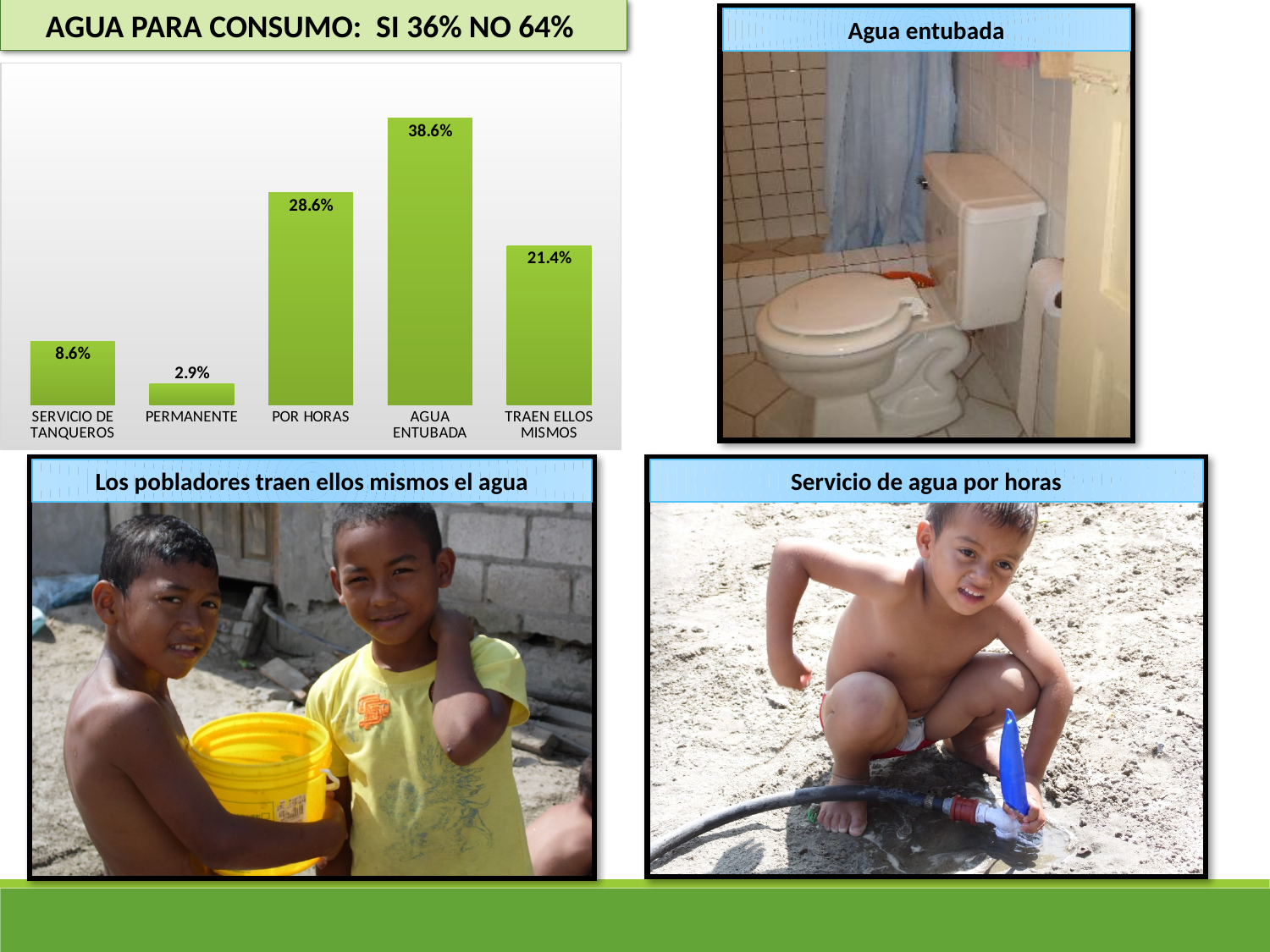
What is the title of the chart? AGUA PARA CONSUMO: SI 36% NO 64% What is the value for PERMANENTE? 2.9% How many categories are shown in the chart? 5 What is the value for AGUA ENTUBADA? 38.6% What is the difference between the values for SERVICIO DE TANQUEROS and PERMANENTE? 5.7% What kind of chart is shown on the slide? Bar chart What is the value for SERVICIO DE TANQUEROS? 8.6% Which category has the highest value? AGUA ENTUBADA What is the difference between the values for AGUA ENTUBADA and POR HORAS? 10.0% Which is larger, the value for POR HORAS or the value for TRAEN ELLOS MISMOS? POR HORAS What is the value for TRAEN ELLOS MISMOS? 21.4% Which category has the lowest value? PERMANENTE